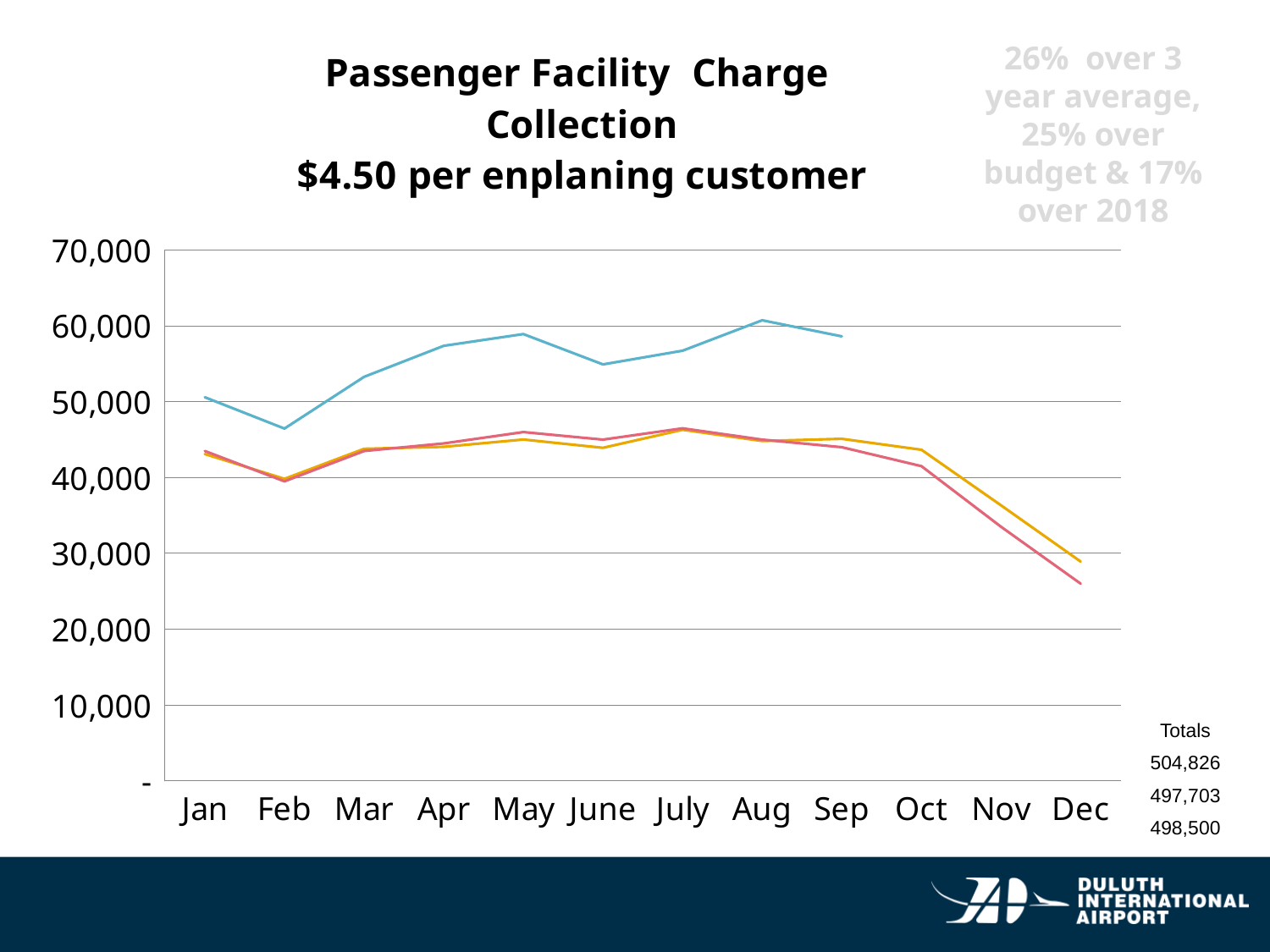
In which month does the blue line reach its lowest value? Feb How many lines are plotted on the chart? 3 Is the value of the blue line in Aug greater or less than 60,000? greater How many months are shown on the x axis of the chart? 12 In which month does the red line reach its lowest value? Dec Is the value of the red line in Dec greater or less than 30,000? less What is the last month for which the blue line has a plotted value? Sep Does the blue line rise or fall from Feb to May? rise In which month does the blue line reach its highest value? Aug Is the value of the blue line in Feb greater or less than 50,000? less Which line has the larger value in Jan, the blue line or the red line? blue line What kind of chart is shown on the slide? line chart